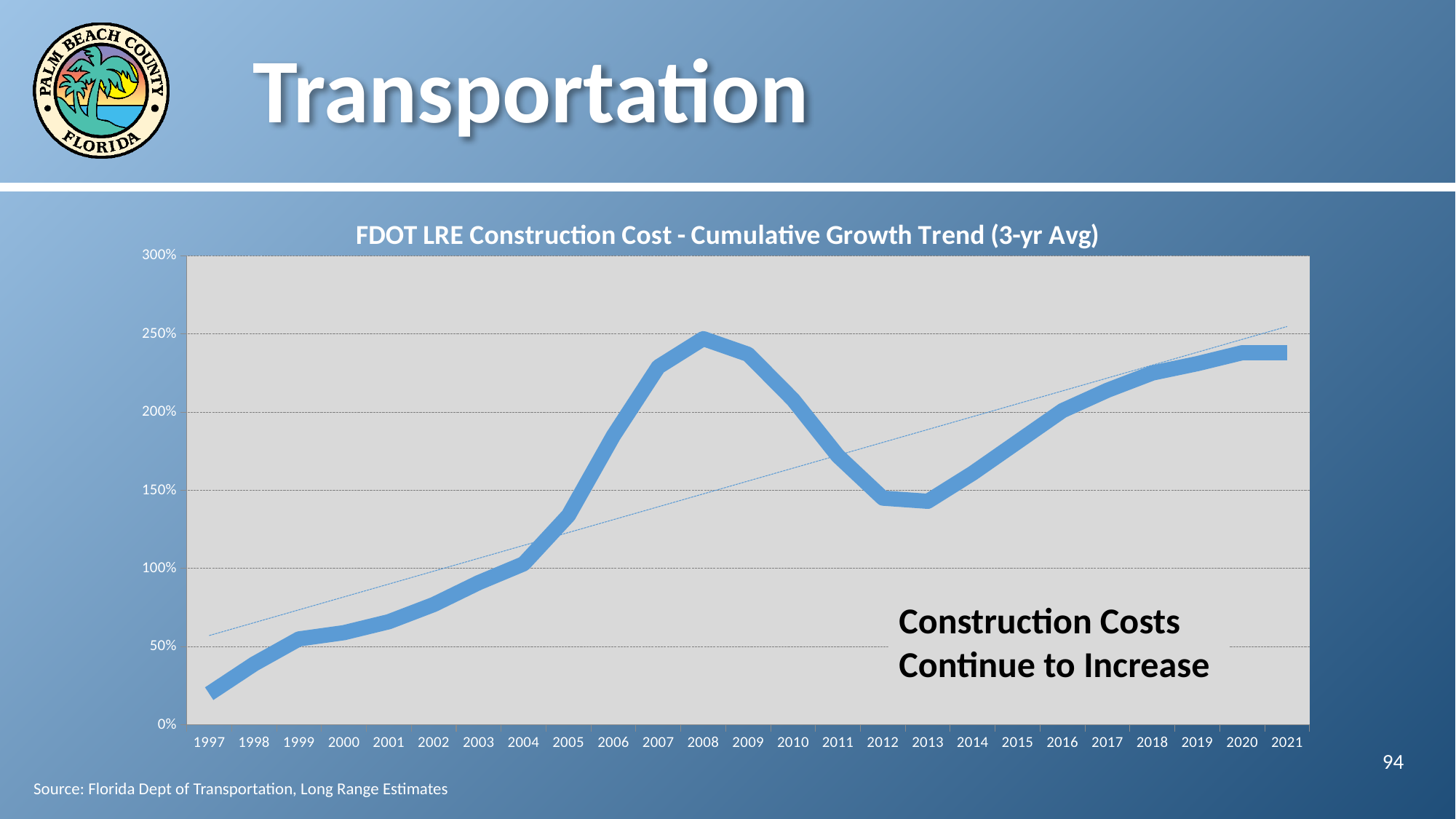
Is the value for 2021 greater or less than 200%? greater In which year is the cumulative growth trend at its lowest value? 1997 How many years are plotted along the x axis of the chart? 25 Which year has the larger value, 2005 or 2019? 2019 Is the value for 2008 greater or less than 200%? greater Is the value for 1997 greater or less than 50%? less What is the title of the chart? FDOT LRE Construction Cost - Cumulative Growth Trend (3-yr Avg) Overall, does the cumulative growth trend rise or fall from 1997 to 2021? Rise In which year does the cumulative growth trend reach its highest value? 2008 Which year has the larger value, 2008 or 2013? 2008 What kind of chart is shown on the slide? Line chart